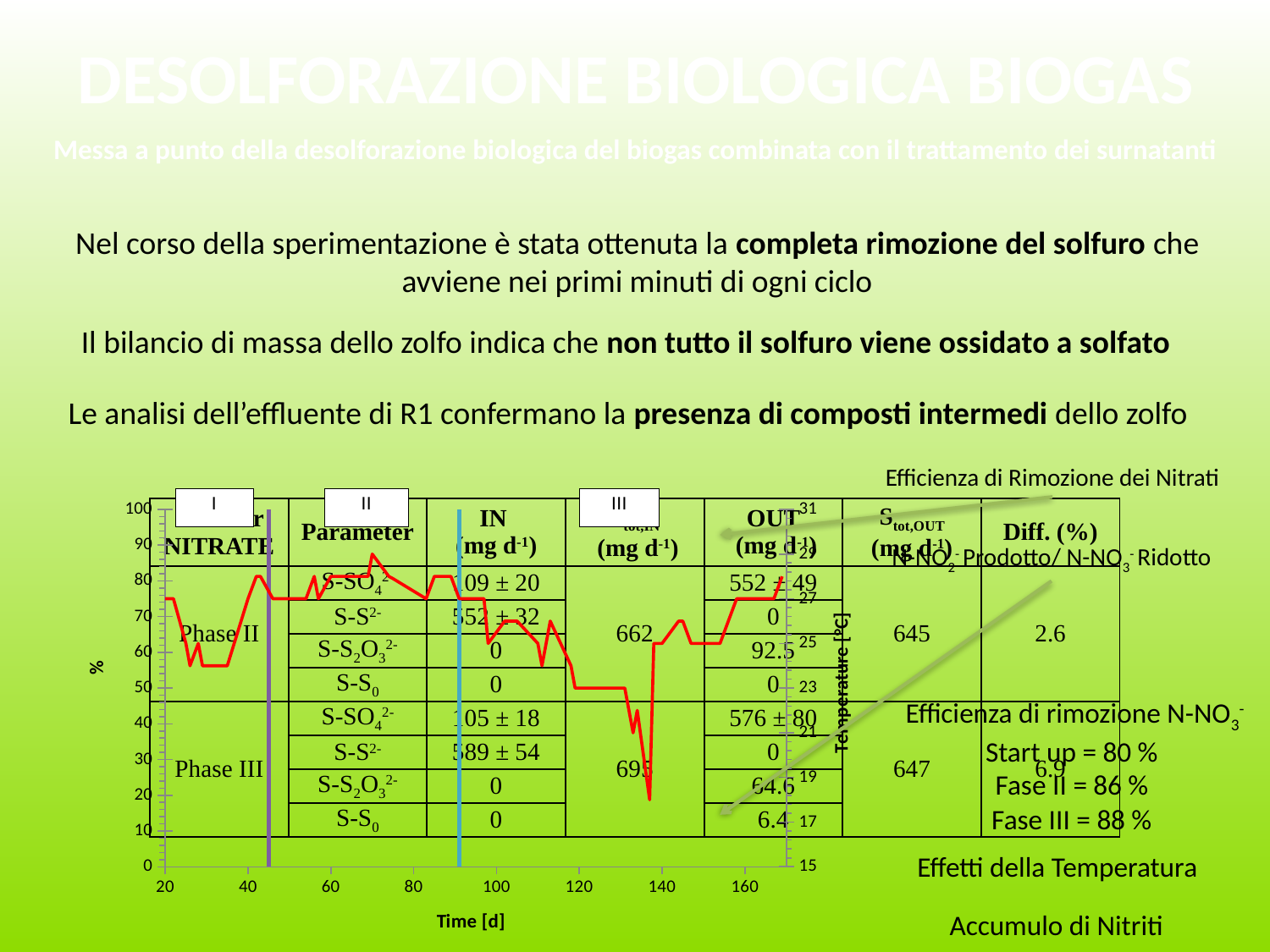
What is the title of the x axis of the chart? Time [d] Does the red line rise or fall between day 135 and day 150? rise Does the red line rise or fall between day 120 and day 135? fall How many phase labels (I, II, III) are marked above the chart? 3 Is the lowest point of the red line (near day 135) greater or less than 40? less What kind of chart is shown at the bottom left of the slide? line chart What colour is the plotted line in the chart? red